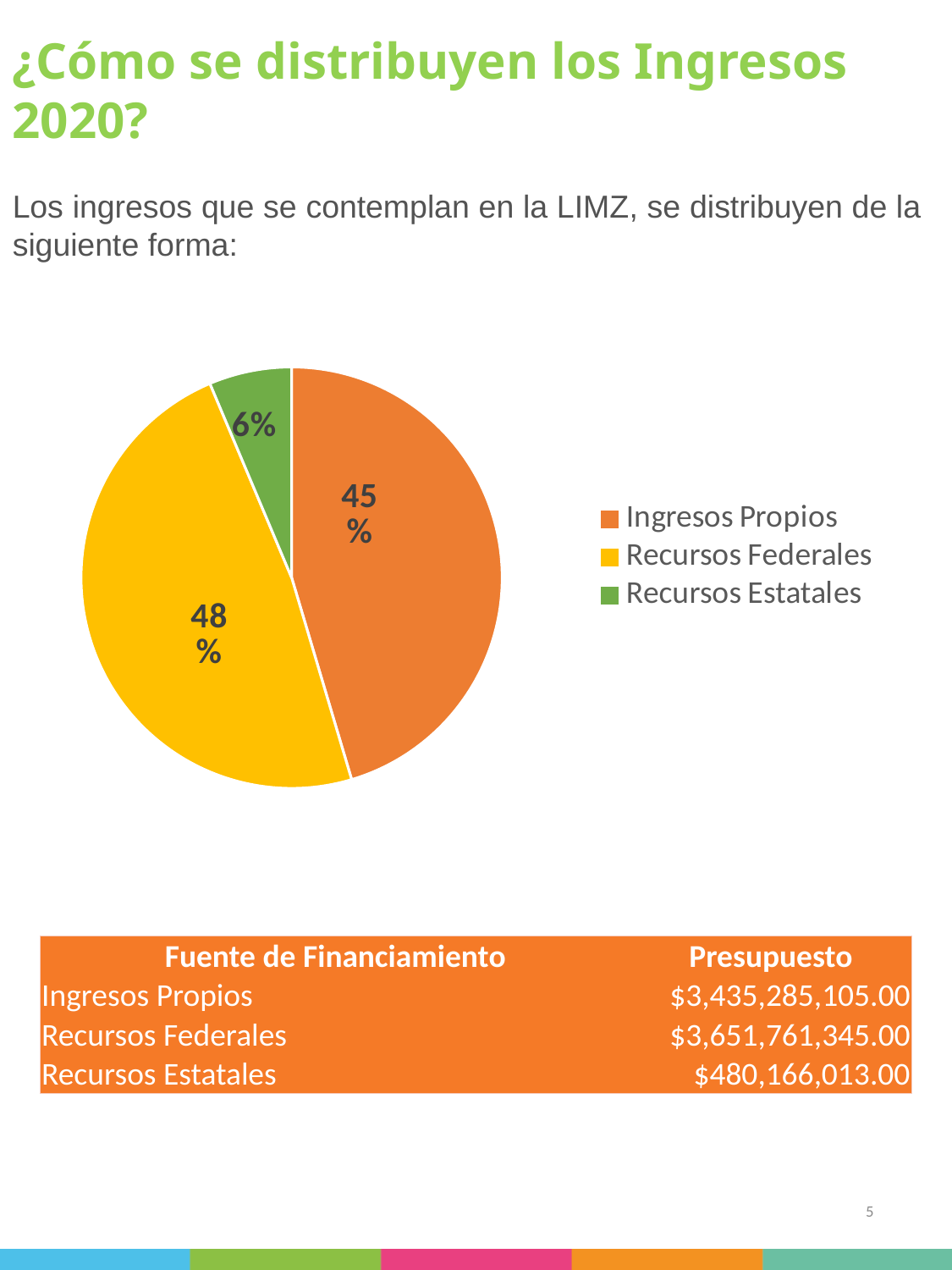
Which slice is larger, Ingresos Propios or Recursos Estatales? Ingresos Propios Which category has the smallest slice of the pie? Recursos Estatales What share of the pie does Recursos Estatales represent? 6% How many slices does the pie chart have? 3 What is the difference in percentage points between the Recursos Federales slice and the Ingresos Propios slice? 3 percentage points How many entries does the legend list? 3 What colour is the Recursos Estatales slice in the pie chart? Green Which category has the largest slice of the pie? Recursos Federales What is the difference in percentage points between the Ingresos Propios slice and the Recursos Estatales slice? 39 percentage points What share of the pie does Recursos Federales represent? 48% What share of the pie does Ingresos Propios represent? 45% What kind of chart is shown on the slide? Pie chart